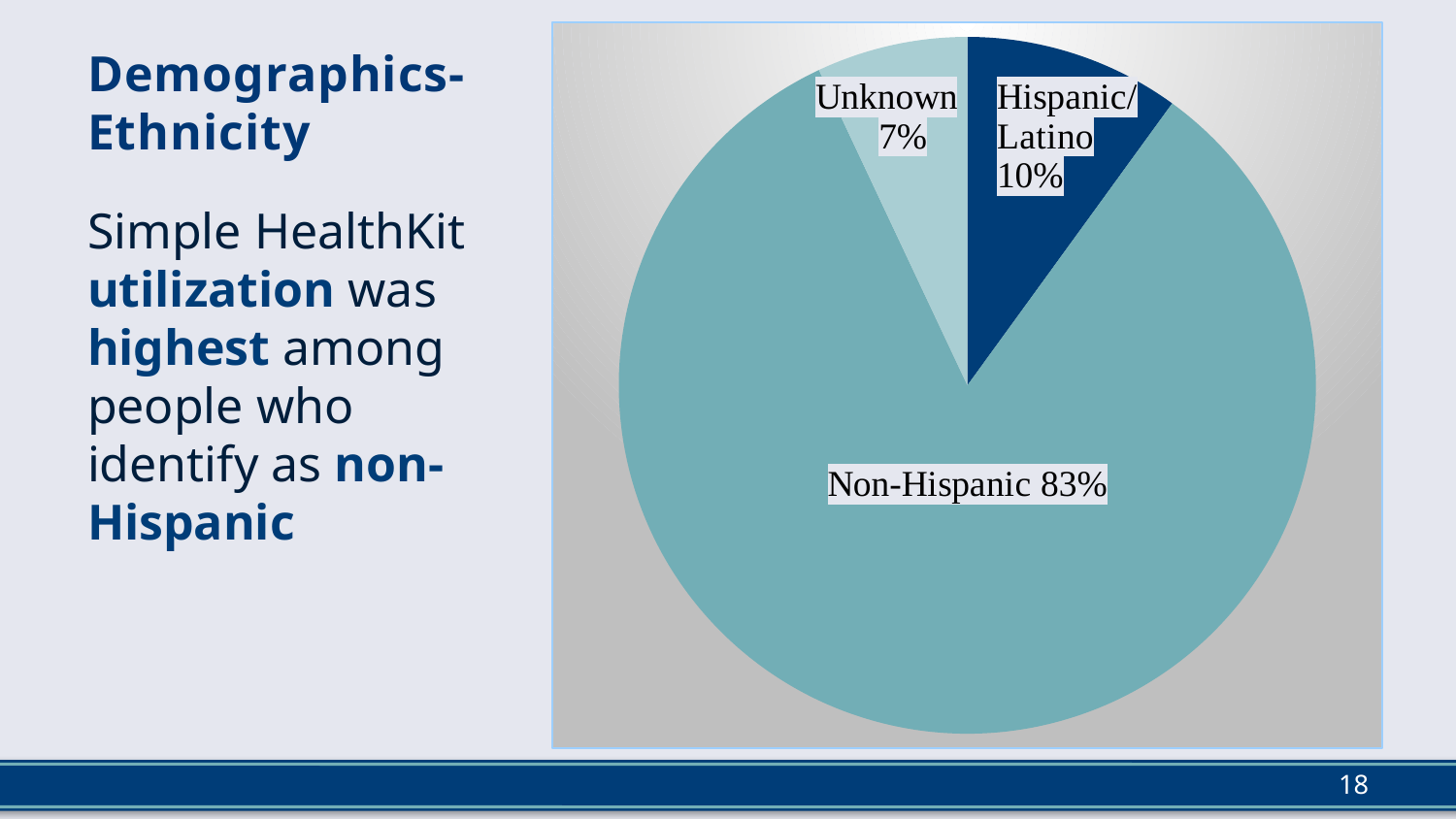
Which category has the largest slice of the pie? Non-Hispanic What share of the pie is Unknown? 7% What colour is the Hispanic/Latino slice? dark blue What is the difference in percentage points between the Hispanic/Latino and Unknown slices? 3 What kind of chart is shown on the slide? pie chart Is the Non-Hispanic share greater or less than 50%? greater How many slices does the pie chart have? 3 What share of the pie is Non-Hispanic? 83% What share of the pie is Hispanic/Latino? 10% What is the difference in percentage points between the Non-Hispanic and Hispanic/Latino slices? 73 Which slice is larger, Hispanic/Latino or Unknown? Hispanic/Latino Which category has the smallest slice of the pie? Unknown